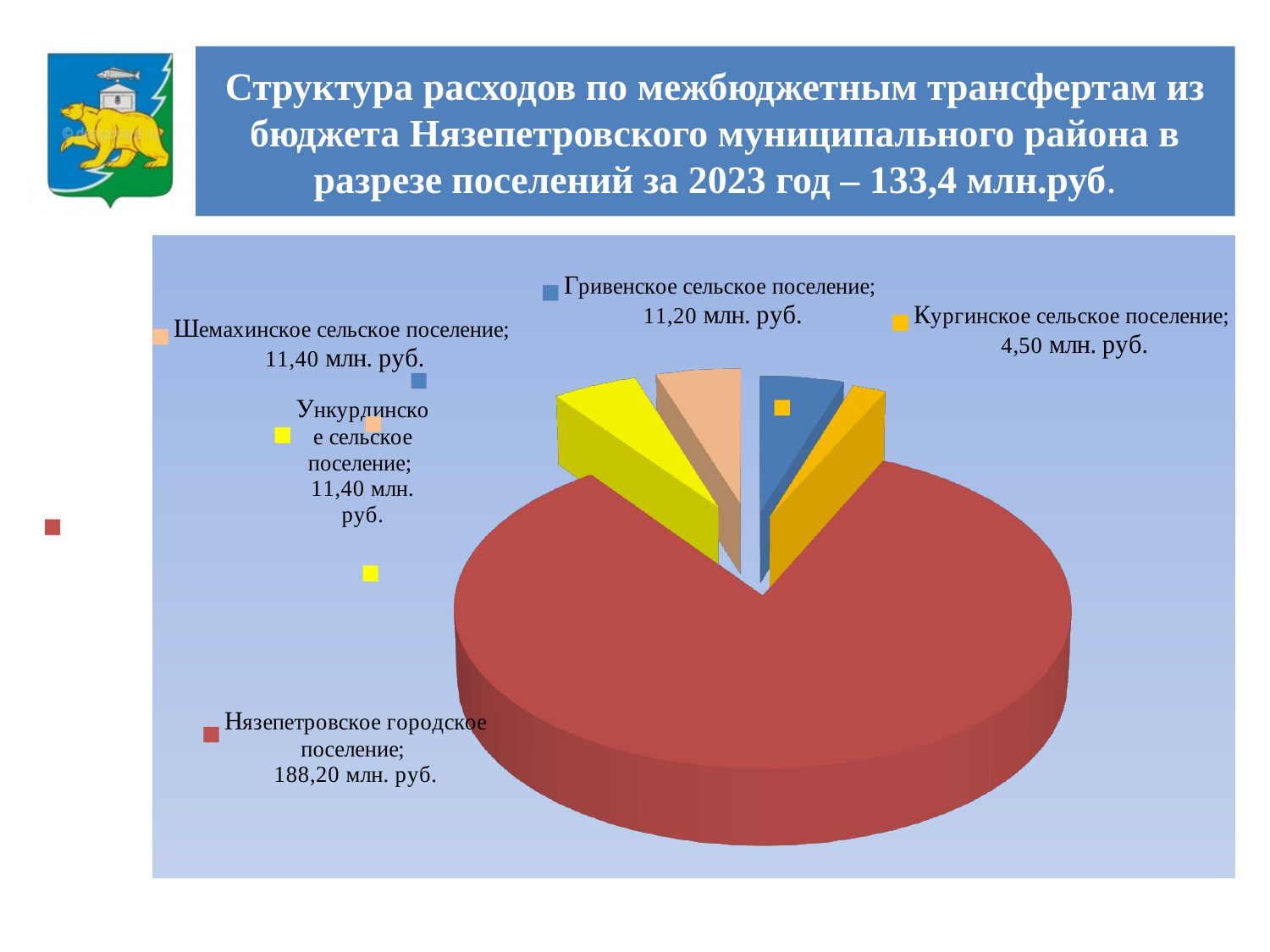
What is the difference between the values for Шемахинское сельское поселение and Гривенское сельское поселение? 0,20 млн. руб. Which settlement has the smallest slice of the pie? Кургинское сельское поселение What is the value for Нязепетровское городское поселение? 188,20 млн. руб. What kind of chart is shown on the slide? pie chart How many slices does the pie chart have? 5 What is the value for Шемахинское сельское поселение? 11,40 млн. руб. What is the value for Кургинское сельское поселение? 4,50 млн. руб. Which is larger, the value for Гривенское сельское поселение or the value for Кургинское сельское поселение? Гривенское сельское поселение What is the difference between the values for Нязепетровское городское поселение and Кургинское сельское поселение? 183,70 млн. руб. What is the value for Гривенское сельское поселение? 11,20 млн. руб. Which settlement has the largest slice of the pie? Нязепетровское городское поселение What colour is the slice for Нязепетровское городское поселение? red